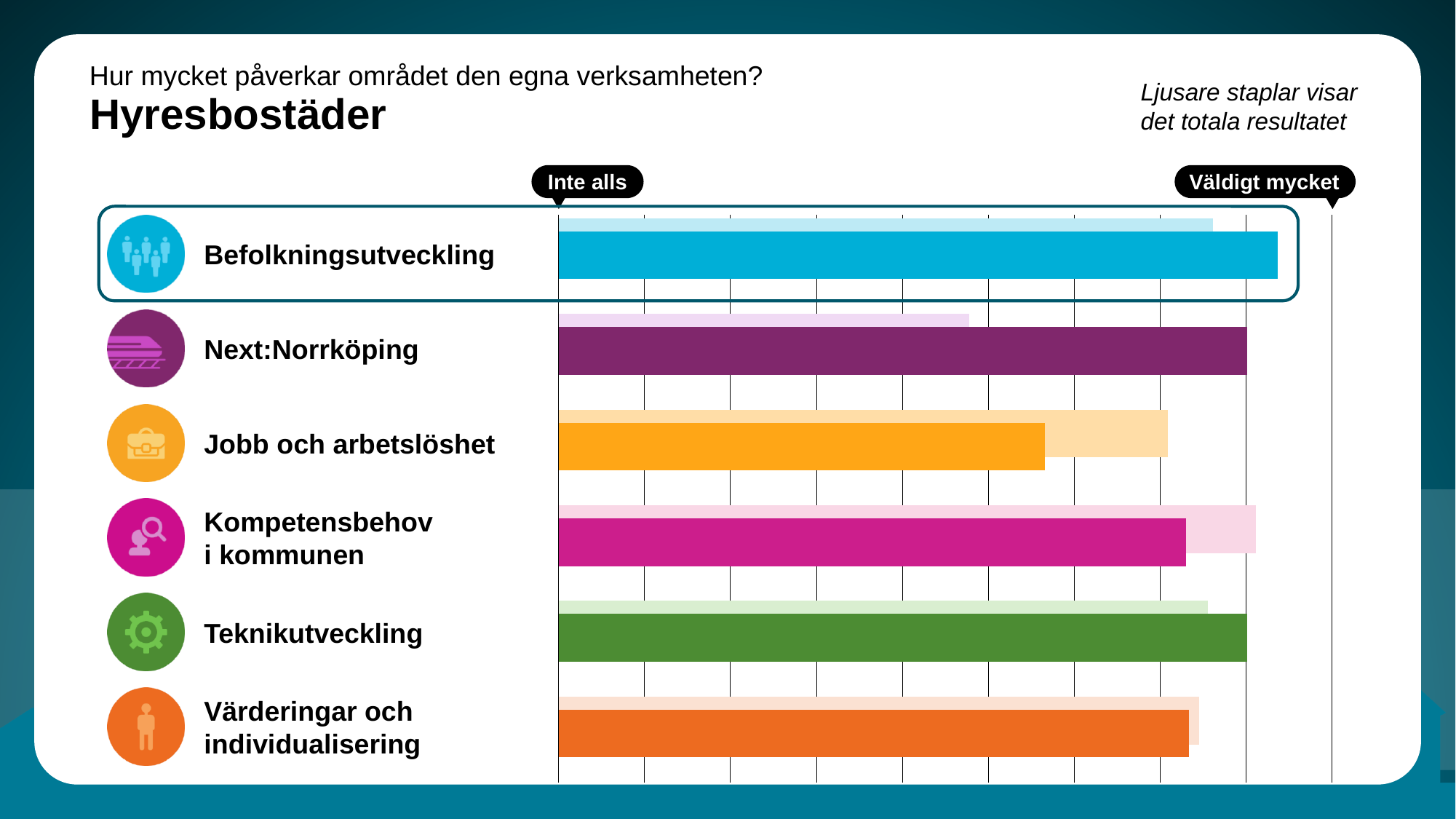
For Next:Norrköping, which bar is longer: the dark bar or the light bar? the dark bar Which category is highlighted with an outlined box on the slide? Befolkningsutveckling Which category has the shortest light bar (total result)? Next:Norrköping For Jobb och arbetslöshet, which bar is longer: the dark bar or the light bar? the light bar For Kompetensbehov i kommunen, which bar is longer: the dark bar or the light bar? the light bar Which category has the longest dark bar? Befolkningsutveckling How many categories (areas) are shown in the chart? 6 What kind of chart is shown on the slide? bar chart Which category has the longest light bar (total result)? Kompetensbehov i kommunen What is the label at the left end of the chart's axis? Inte alls Which category has the shortest dark bar? Jobb och arbetslöshet